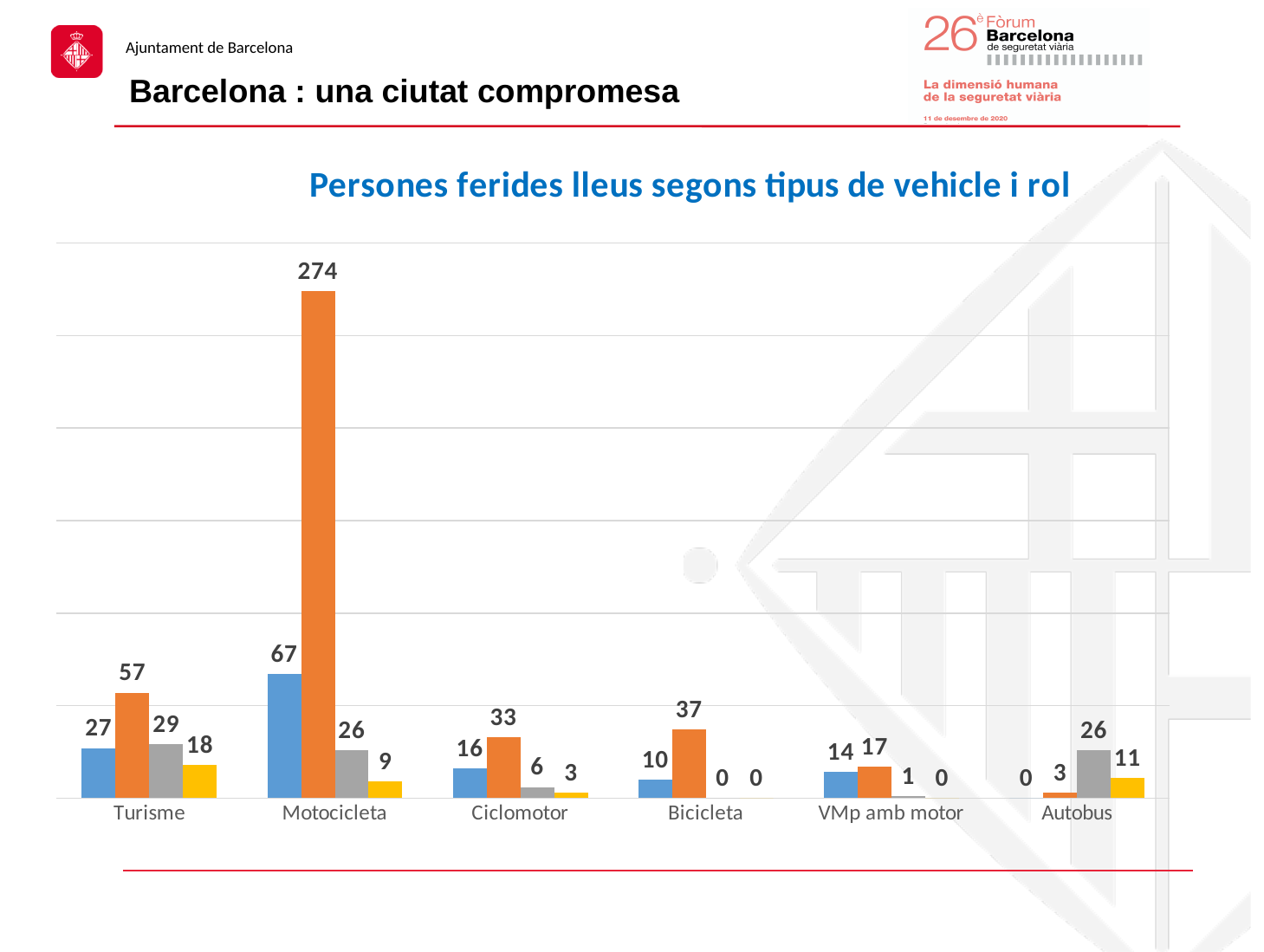
What is the value of the yellow bar for Ciclomotor? 3 What is the total of the four bars for Turisme? 131 Which is larger for Bicicleta, the blue bar or the orange bar? the orange bar What is the value of the blue bar for Turisme? 27 Which category has the highest orange bar? Motocicleta Which category has the lowest blue bar? Autobus How many vehicle categories are shown on the x axis? 6 What is the title of the chart? Persones ferides lleus segons tipus de vehicle i rol What is the difference between the orange bar and the blue bar for Motocicleta? 207 What is the value of the orange bar for Motocicleta? 274 What kind of chart is shown on the slide? bar chart What is the value of the grey bar for Autobus? 26